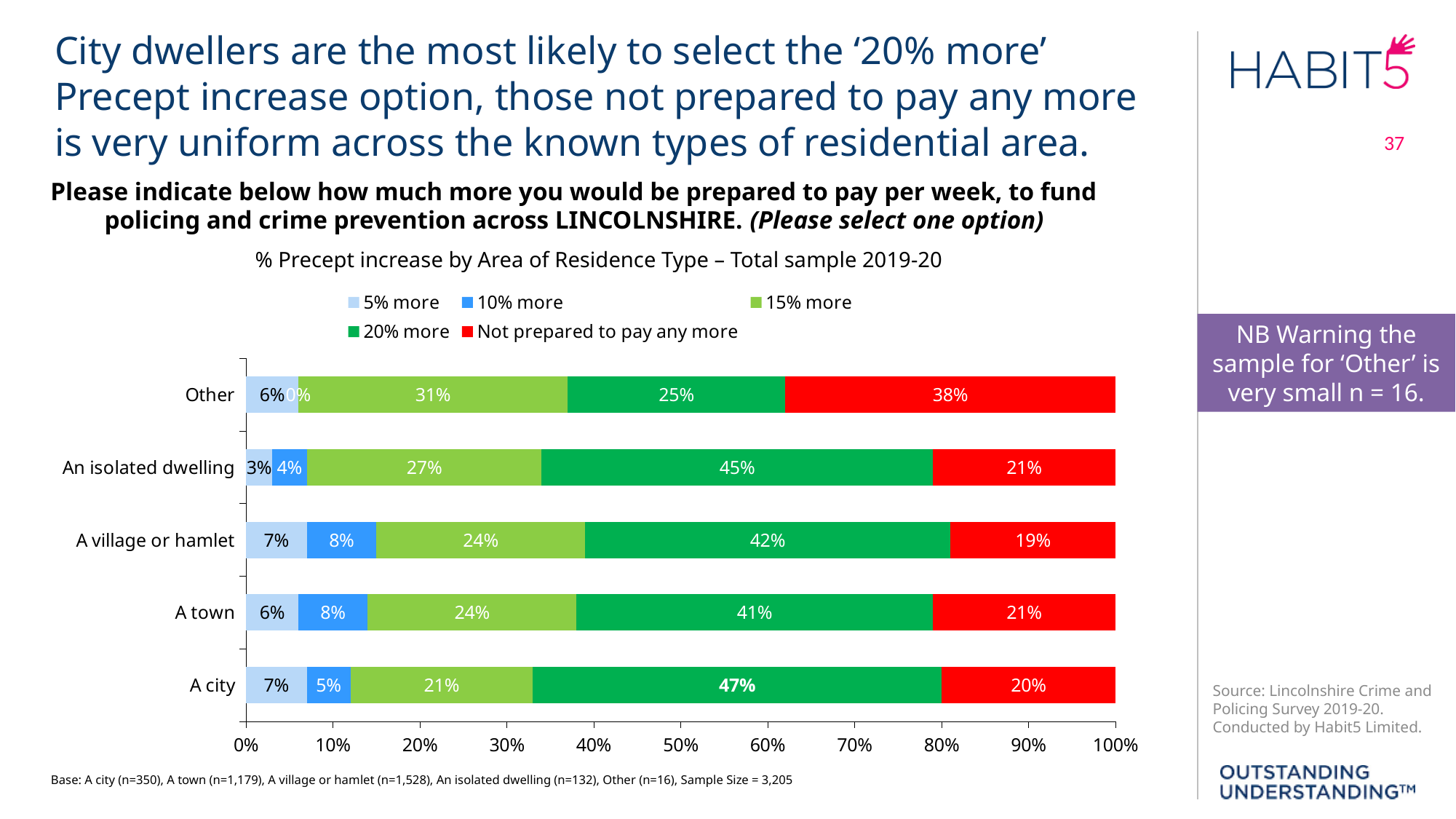
What percentage of 'Other' respondents selected '10% more'? 0% Which area of residence type has the highest share of respondents selecting '20% more'? A city What is the difference between the '20% more' share for 'A city' and for 'A town'? 6% What percentage of 'An isolated dwelling' respondents were 'Not prepared to pay any more'? 21% Which colour represents 'Not prepared to pay any more' in the chart? Red Which area of residence type has the lowest share of respondents selecting '20% more'? Other How many area of residence types are shown on the chart? 5 What kind of chart is shown on the slide? Stacked bar chart How many series does the legend list? 5 What percentage of 'A village or hamlet' respondents selected '15% more'? 24% Which is larger: the 'Not prepared to pay any more' share for 'Other' or for 'A village or hamlet'? Other What percentage of 'A city' respondents selected '20% more'? 47%